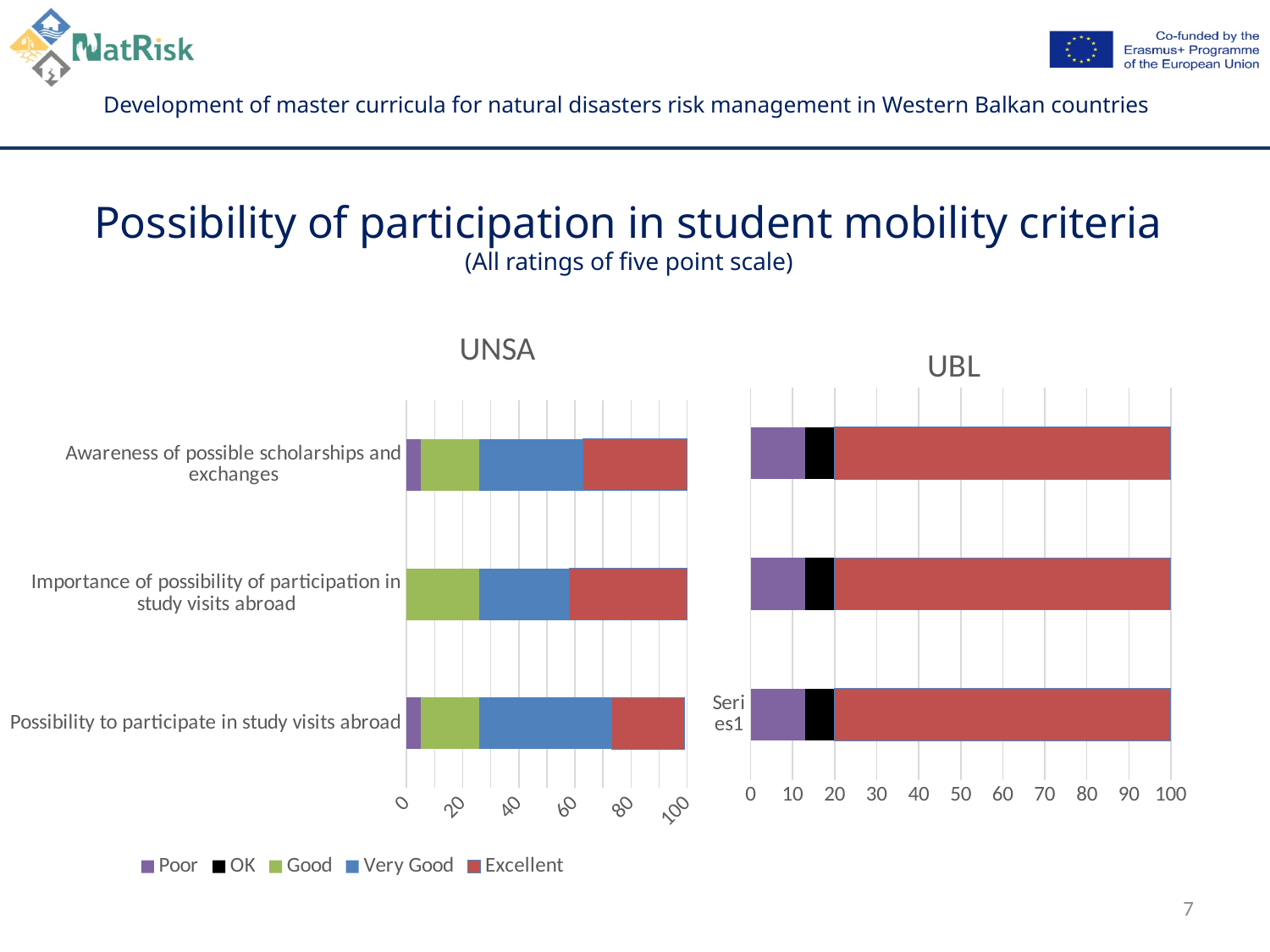
In the UNSA chart, is the Very Good value for 'Possibility to participate in study visits abroad' greater or less than 20? greater In the UBL chart, is the Excellent value for the top bar greater or less than 50? greater In the UNSA chart, is the Excellent segment larger for 'Awareness of possible scholarships and exchanges' or for 'Possibility to participate in study visits abroad'? Awareness of possible scholarships and exchanges In the UNSA chart, which category has no Poor segment? Importance of possibility of participation in study visits abroad In the UBL chart, is the Poor value for the bottom bar (Series1) greater or less than 20? less In the UNSA chart, is the Very Good segment larger for 'Possibility to participate in study visits abroad' or for 'Awareness of possible scholarships and exchanges'? Possibility to participate in study visits abroad How many categories are shown in the UNSA chart? 3 Which rating does the red colour represent in the legend? Excellent How many bars are shown in the UBL chart? 3 What type of chart is the UNSA chart? bar chart How many series does the legend list? 5 In the UBL chart, what is the total of the top stacked bar? 100